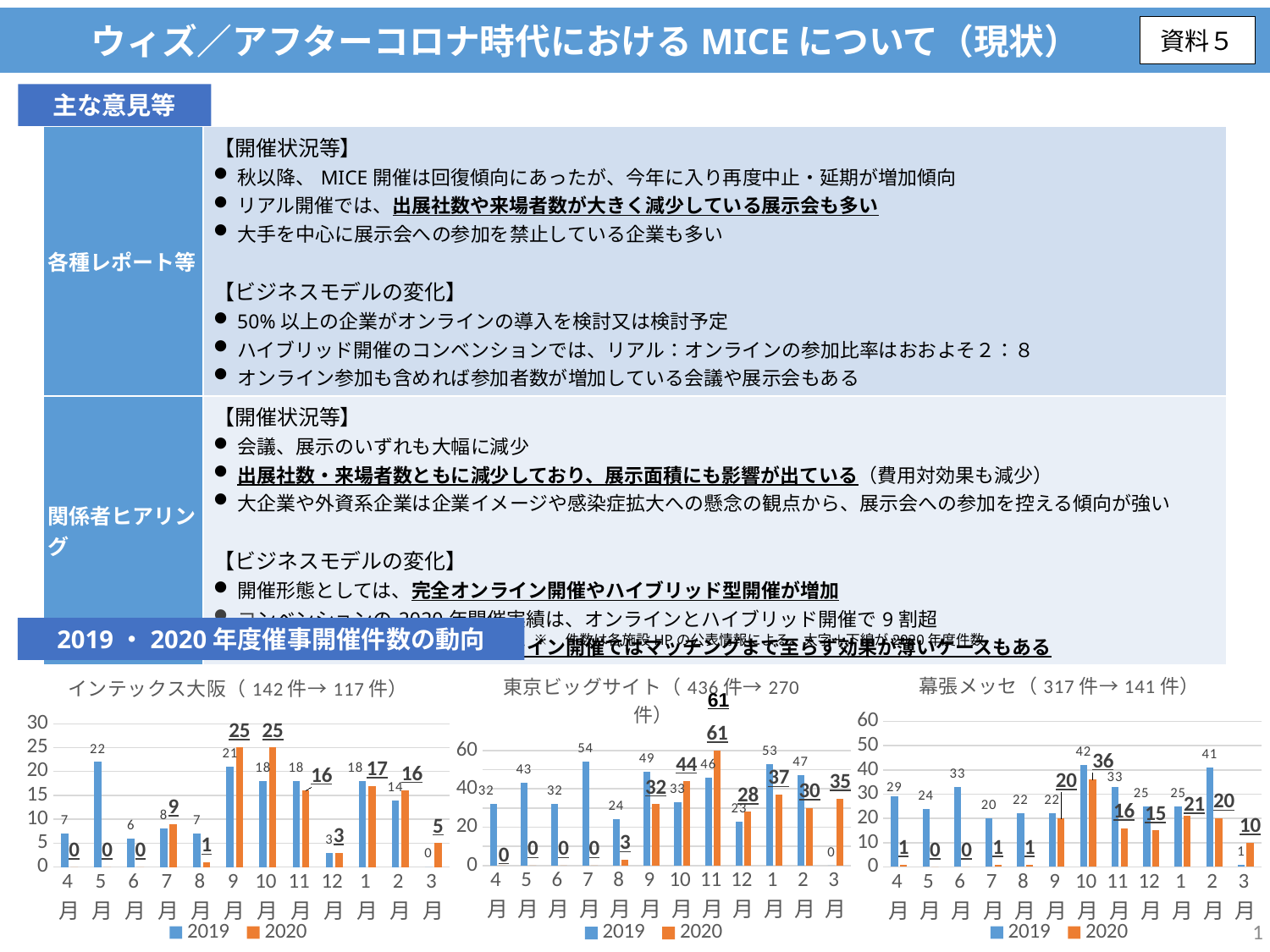
In the 東京ビッグサイト chart, what is the difference between the 2019 and 2020 values for 1月? 16 In the 幕張メッセ chart, which month has the highest 2020 value? 10月 How many series does the legend of the 幕張メッセ chart list? 2 What kind of chart is the インテックス大阪 chart? Bar chart In the 東京ビッグサイト chart, which month has the highest 2019 value? 7月 In the インテックス大阪 chart, what is the 2020 value for 9月? 25 In the 幕張メッセ chart, what is the difference between the 2019 and 2020 values for 2月? 21 In the 東京ビッグサイト chart, what is the 2020 value for 11月? 61 In the 東京ビッグサイト chart, which is larger for 10月, the 2019 value or the 2020 value? 2020 In the インテックス大阪 chart, what is the 2019 value for 5月? 22 In the インテックス大阪 chart, which month has the highest 2019 value? 5月 In the 幕張メッセ chart, what is the 2019 value for 10月? 42